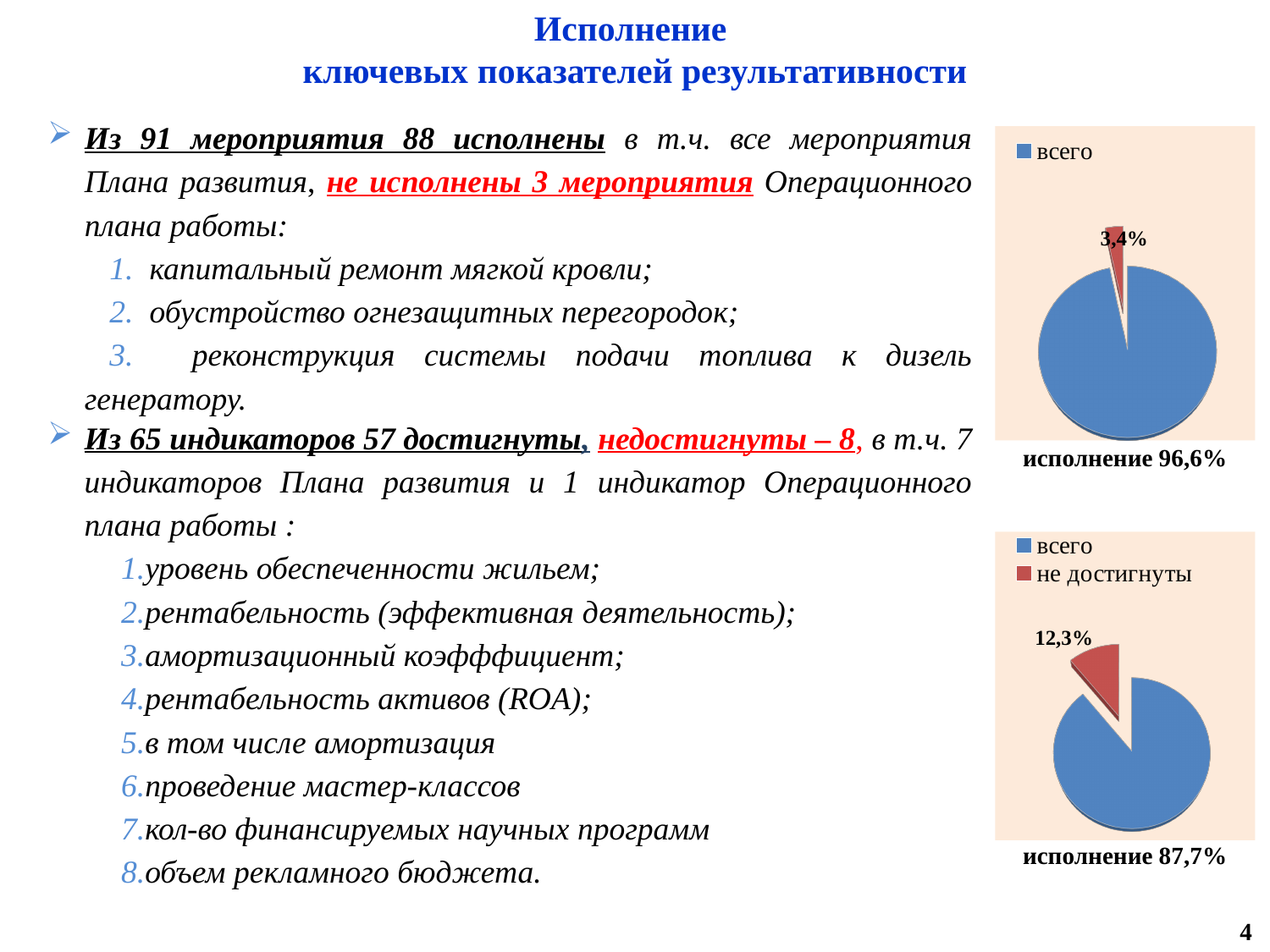
What kind of chart is the top chart on the right of the slide? pie chart In the bottom pie chart, is the 'не достигнуты' slice greater or less than 50%? less How many entries does the legend of the top pie chart list? 1 In the bottom pie chart, what percentage is printed on the small red slice? 12,3% In the top pie chart, what percentage is printed on the small red slice? 3,4% What are the legend entries of the bottom pie chart? всего, не достигнуты In the bottom pie chart, which slice is larger: 'всего' or 'не достигнуты'? всего What is the difference between the labelled slice of the bottom pie chart (12,3%) and the labelled slice of the top pie chart (3,4%)? 8,9% Which chart has the larger labelled small slice, the top pie chart (3,4%) or the bottom pie chart (12,3%)? the bottom pie chart How many slices does the bottom pie chart have? 2 What caption is printed below the top pie chart? исполнение 96,6% How many entries does the legend of the bottom pie chart list? 2